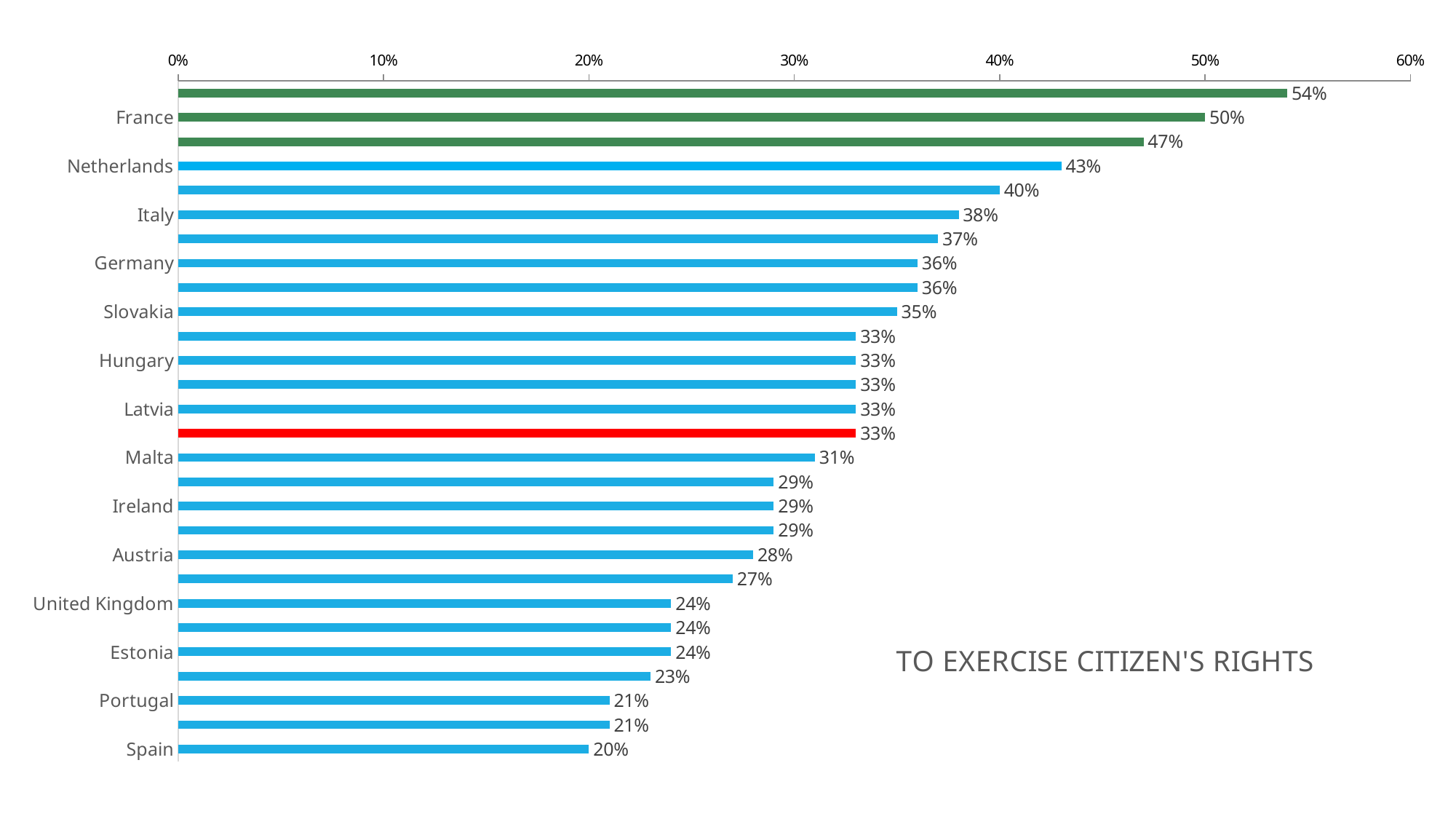
What is the text shown in the lower right of the chart? TO EXERCISE CITIZEN'S RIGHTS Which labelled country has the lowest value? Spain What is the value for Spain? 20% What kind of chart is shown on the slide? bar chart What colour is the bar directly below Latvia? red What is the value for Germany? 36% Which has a larger value, Slovakia or Malta? Slovakia What is the difference between the values for France and Italy? 12% What is the value for Netherlands? 43% What is the value for France? 50% How many bars are plotted in the chart? 28 Is the value for Austria greater or less than 30%? less